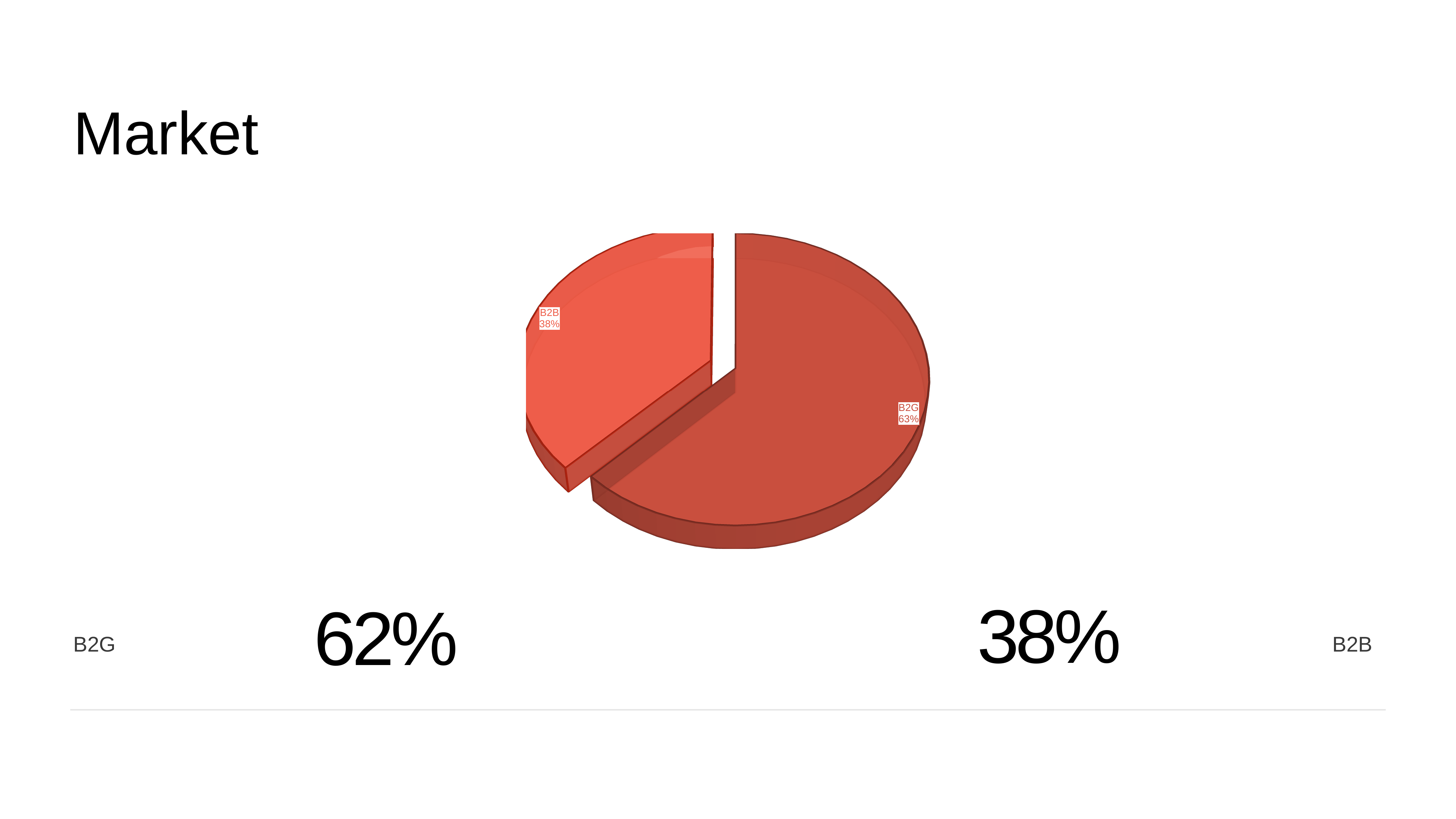
Which slice of the pie chart is the smallest? B2B According to the chart's data labels, what is the difference between the B2G and B2B shares? 25% How many slices does the pie chart have? 2 According to the data label on the pie chart, what share is B2G? 63% Which slice is pulled out (exploded) from the pie chart? B2B What share of the pie chart is labelled for B2B? 38% What is the title of the slide containing the pie chart? Market Is the B2B share in the pie chart greater or less than 50%? less Which is larger in the pie chart, B2B or B2G? B2G What kind of chart is shown on the slide? pie chart Which slice of the pie chart is the largest? B2G